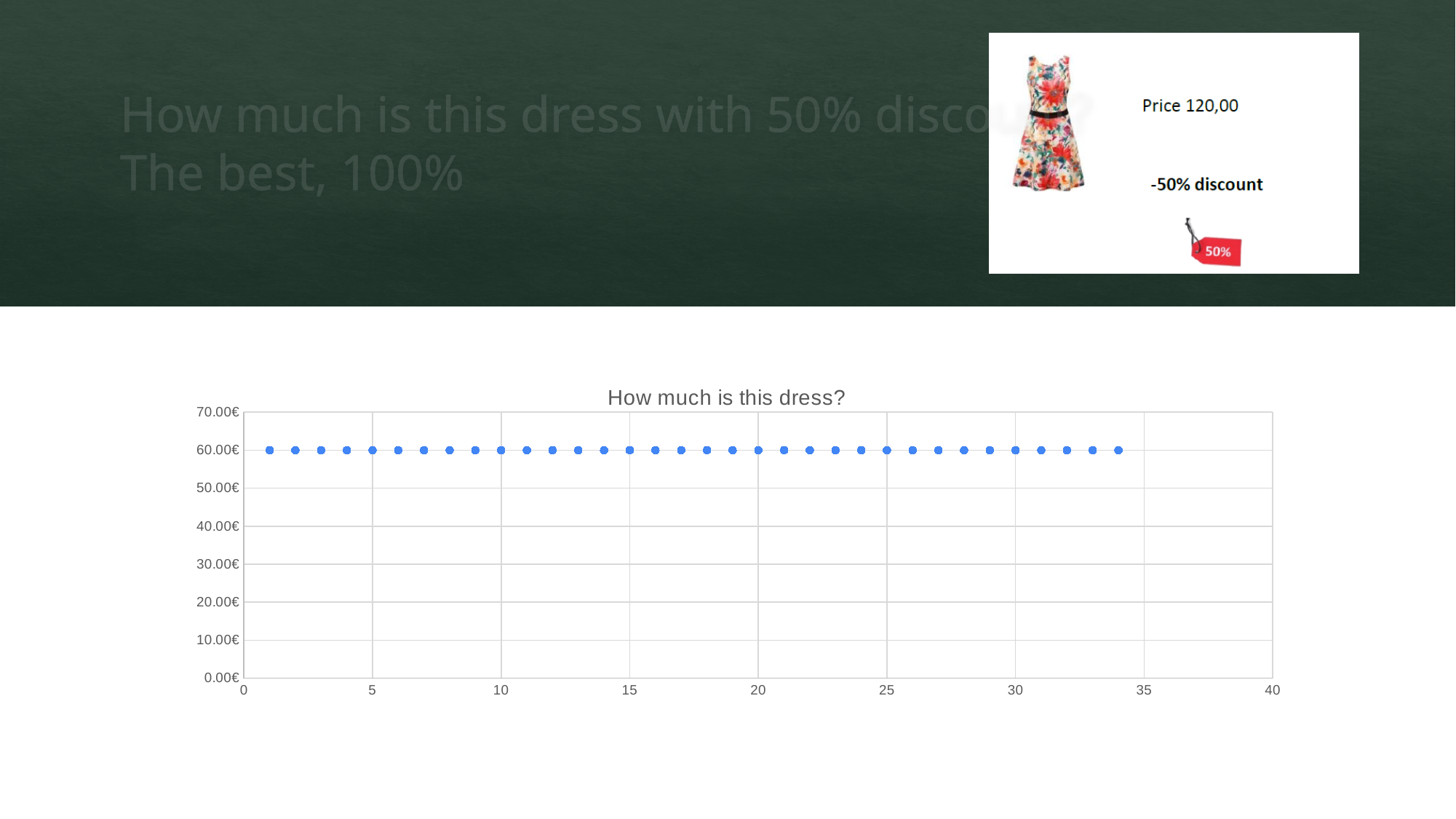
What is the y-axis value of the point at x = 1? 60.00€ What kind of chart is shown on the slide? scatter chart What is the highest value shown on the y-axis? 70.00€ Is the value of the point at x = 30 larger than, smaller than, or equal to the value at x = 15? equal What is the y-axis value of the point at x = 10? 60.00€ What is the title of the chart? How much is this dress? What is the y-axis value of the point at x = 25? 60.00€ Is the value of the point at x = 5 greater or less than 70.00€? less Do the plotted values rise, fall, or stay constant as x increases? stay constant How many data points are plotted on the chart? 34 Is the value of the point at x = 20 greater or less than 50.00€? greater